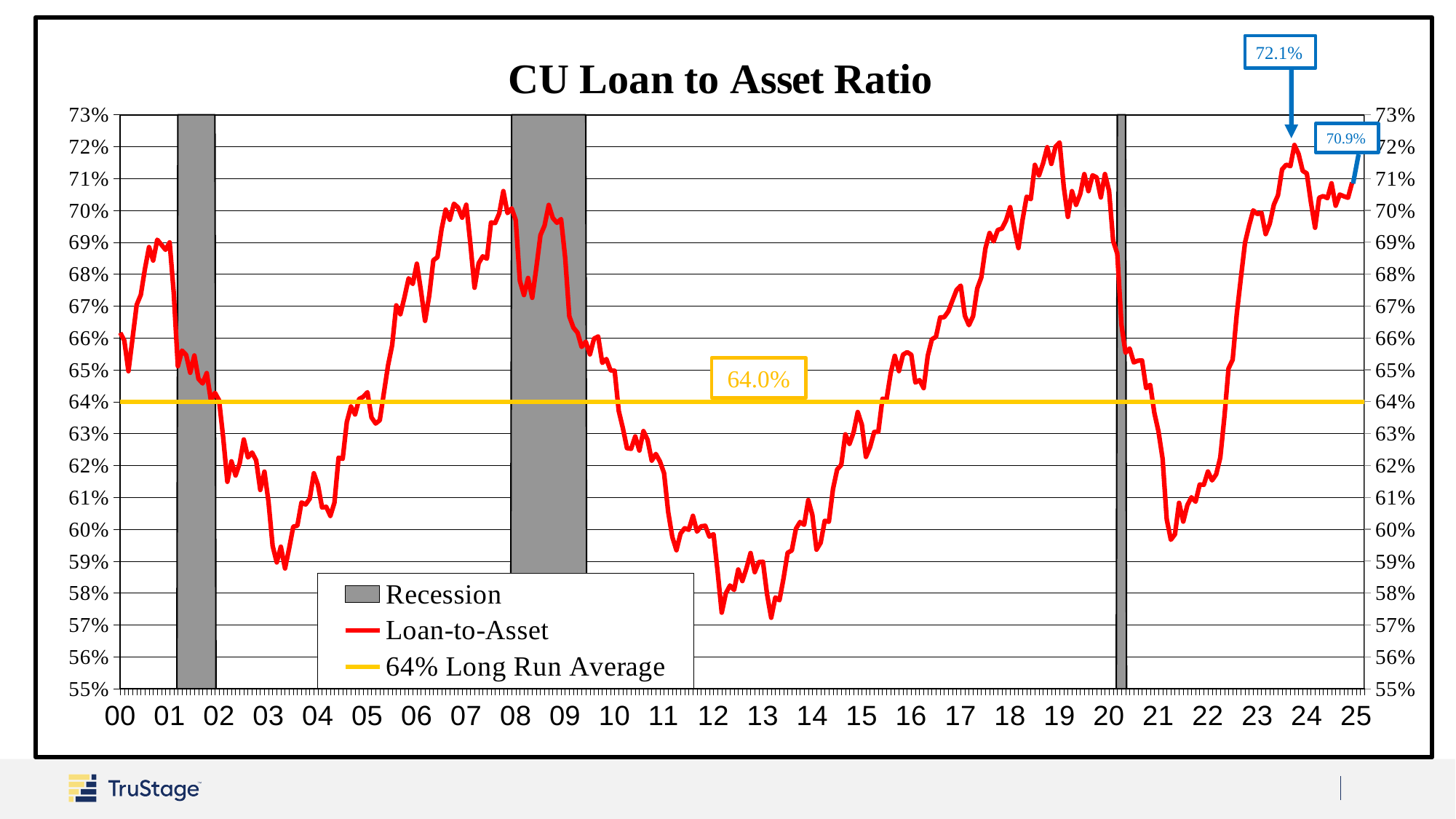
What is the title of the chart? CU Loan to Asset Ratio Which labelled value is larger, the 2024 peak or the 2025 end value? 72.1% What is the labelled peak value of the Loan-to-Asset line near 2024? 72.1% Is the Loan-to-Asset value at the start of 2019 greater or less than 70%? greater Is the Loan-to-Asset value at the start of 2013 greater or less than 60%? less What value is labelled on the long run average line? 64.0% What is the difference between the labelled peak of 72.1% and the final labelled value of 70.9%? 1.2 percentage points What is the labelled value of the Loan-to-Asset line at the end of the series in 2025? 70.9% Between 2020 and 2021, does the Loan-to-Asset ratio rise or fall? fall How many entries does the chart's legend list? 3 What kind of chart is shown on the slide? line chart How many shaded recession periods are shown on the chart? 3